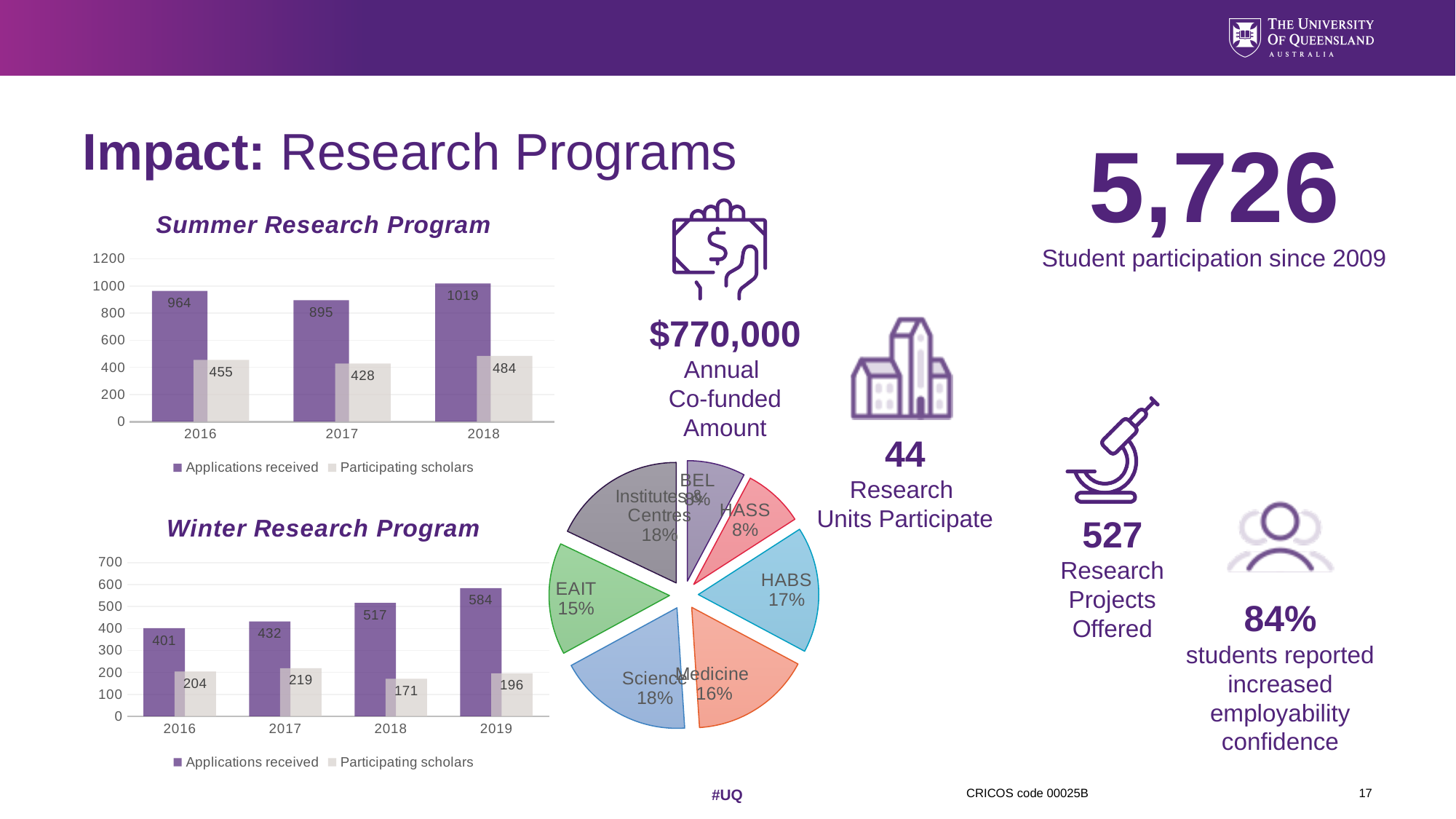
In the Summer Research Program chart, what is the difference between applications received and participating scholars in 2016? 509 What kind of chart is the Winter Research Program chart? bar chart In the Winter Research Program chart, do applications received rise or fall from 2016 to 2019? rise In the Winter Research Program chart, which year had the lowest number of participating scholars? 2018 In the Winter Research Program chart, how many years are shown on the x axis? 4 In the Summer Research Program chart, how many participating scholars were there in 2017? 428 In the Summer Research Program chart, how many applications were received in 2018? 1019 In the Winter Research Program chart, how many applications were received in 2019? 584 In the pie chart, what share does HABS have? 17% In the pie chart, which is larger, EAIT or Science? Science In the Summer Research Program chart, how many series does the legend list? 2 In the Summer Research Program chart, which year had the lowest number of applications received? 2017